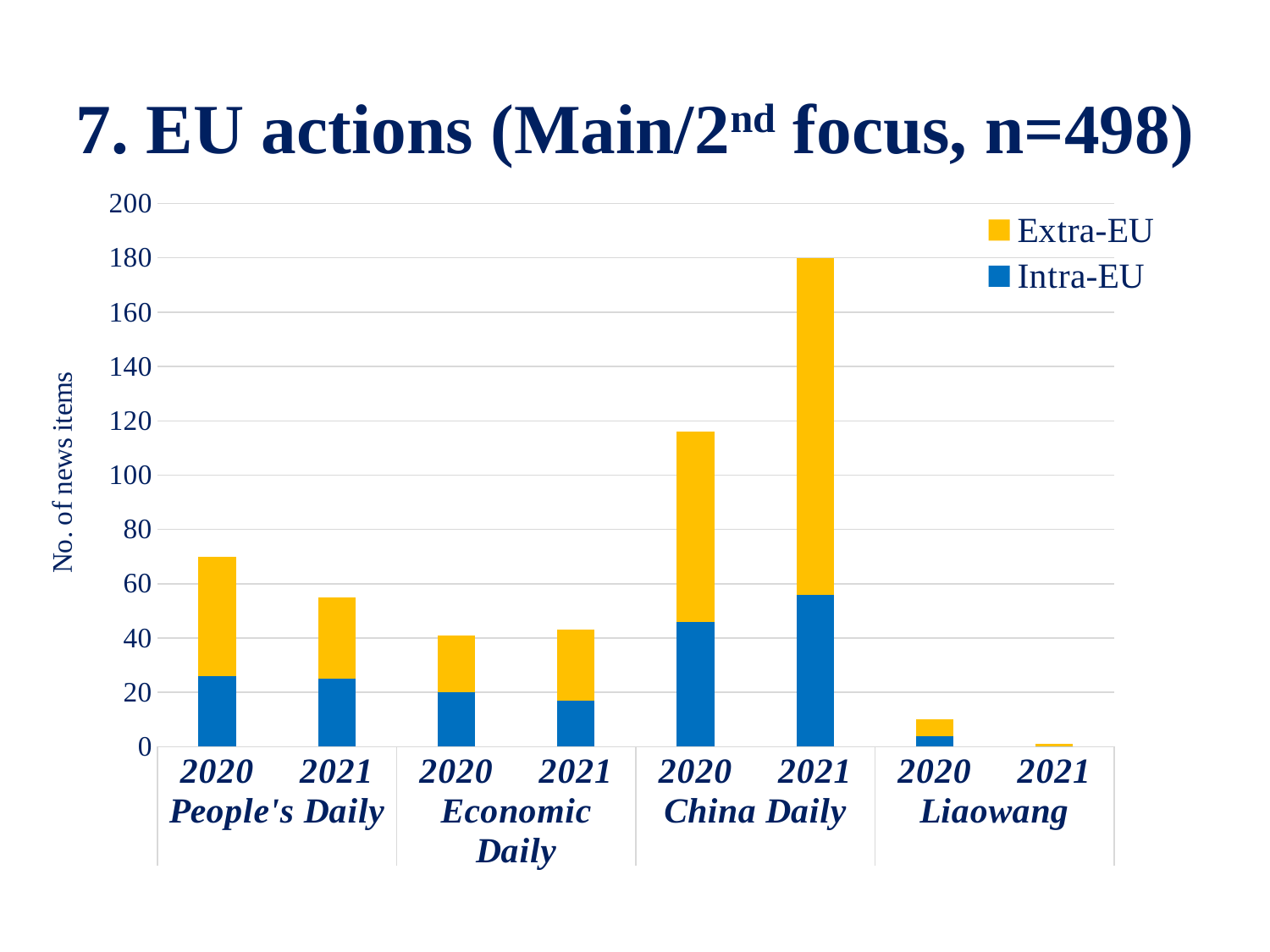
Is the total value for People's Daily 2020 greater or less than 60? greater How many series does the legend list? 2 What is the title of the vertical axis? No. of news items Is the total value for Economic Daily 2021 greater or less than 60? less What kind of chart is shown on the slide? bar chart Is the Intra-EU value for China Daily 2021 greater or less than 40? greater How many stacked bars are plotted in the chart? 8 What are the two series named in the legend? Extra-EU and Intra-EU Which newspaper and year has the shortest stacked bar? Liaowang 2021 For People's Daily, which year has the larger total, 2020 or 2021? 2020 Which newspaper and year has the tallest stacked bar? China Daily 2021